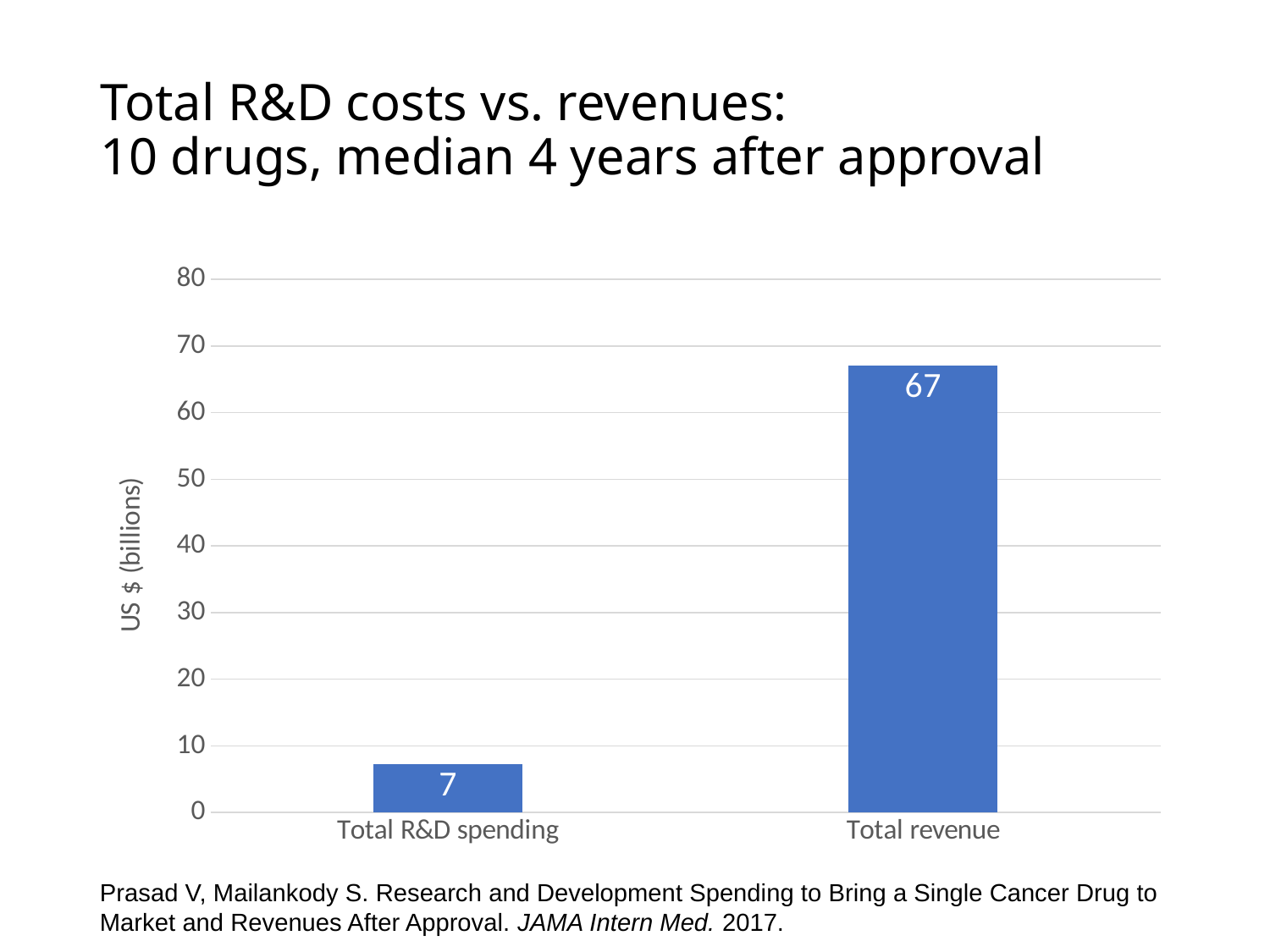
What is the label of the vertical axis? US $ (billions) Which category has the highest value? Total revenue How many categories are shown in the chart? 2 Is the value for Total revenue greater or less than 60? greater What is the difference between Total revenue and Total R&D spending? 60 What is the highest value shown on the vertical axis? 80 Which category has the lowest value? Total R&D spending What is the value for Total R&D spending? 7 What kind of chart is shown on the slide? Bar chart What is the value for Total revenue? 67 Which is larger, Total R&D spending or Total revenue? Total revenue Is the value for Total R&D spending greater or less than 10? less